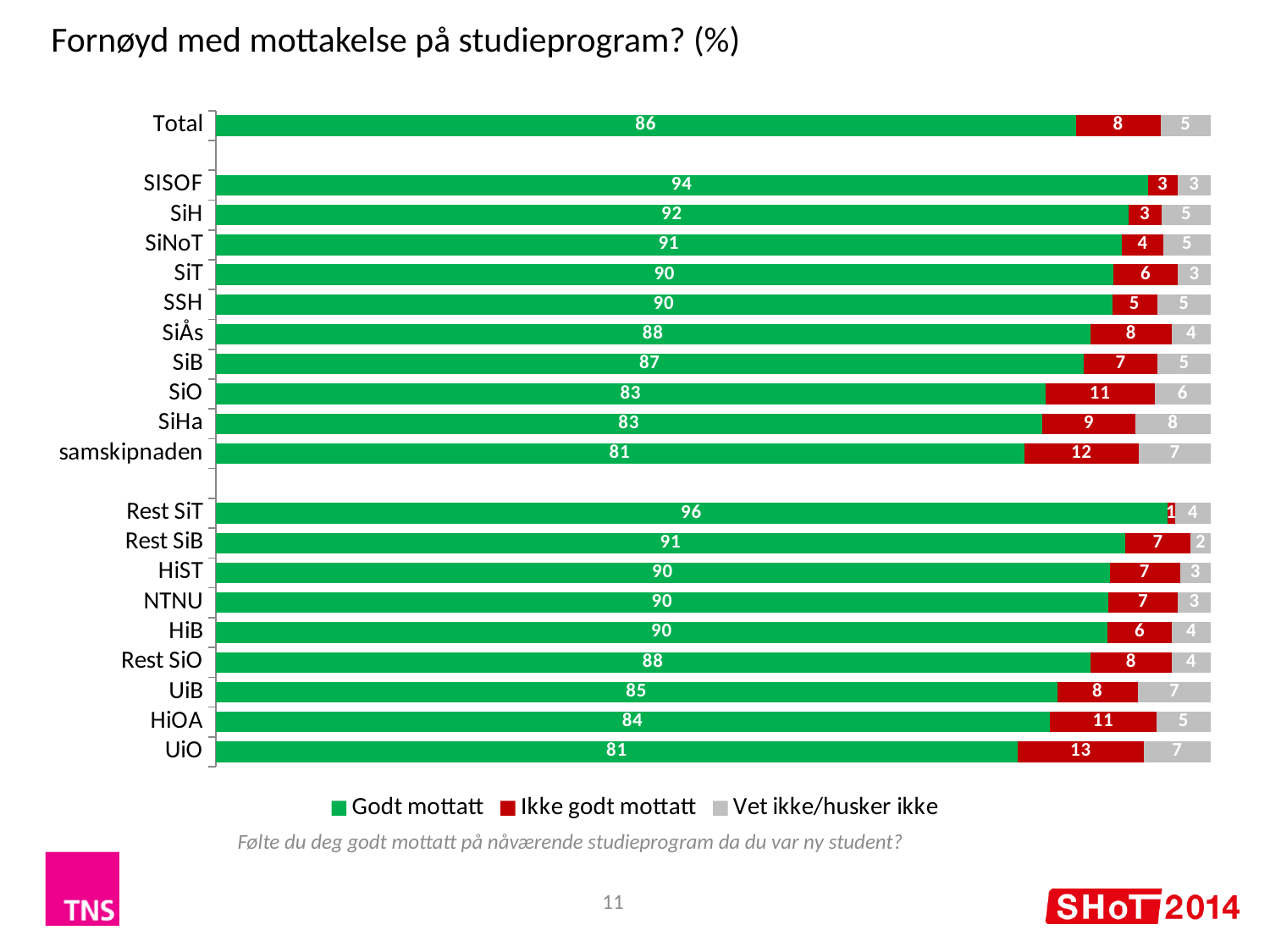
What kind of chart is shown on the slide? Stacked bar chart How many categories are shown on the chart? 20 What is the 'Ikke godt mottatt' value for UiO? 13 Which series is shown in green? Godt mottatt What is the difference between the 'Godt mottatt' values for SISOF and samskipnaden? 13 Which has a larger 'Ikke godt mottatt' value, SiO or SiB? SiO What is the total of the stacked bar for HiOA? 100 What is the 'Godt mottatt' value for Total? 86 Which category has the lowest 'Ikke godt mottatt' value? Rest SiT What is the 'Vet ikke/husker ikke' value for SiHa? 8 Which category has the highest 'Godt mottatt' value? Rest SiT How many series does the legend list? 3